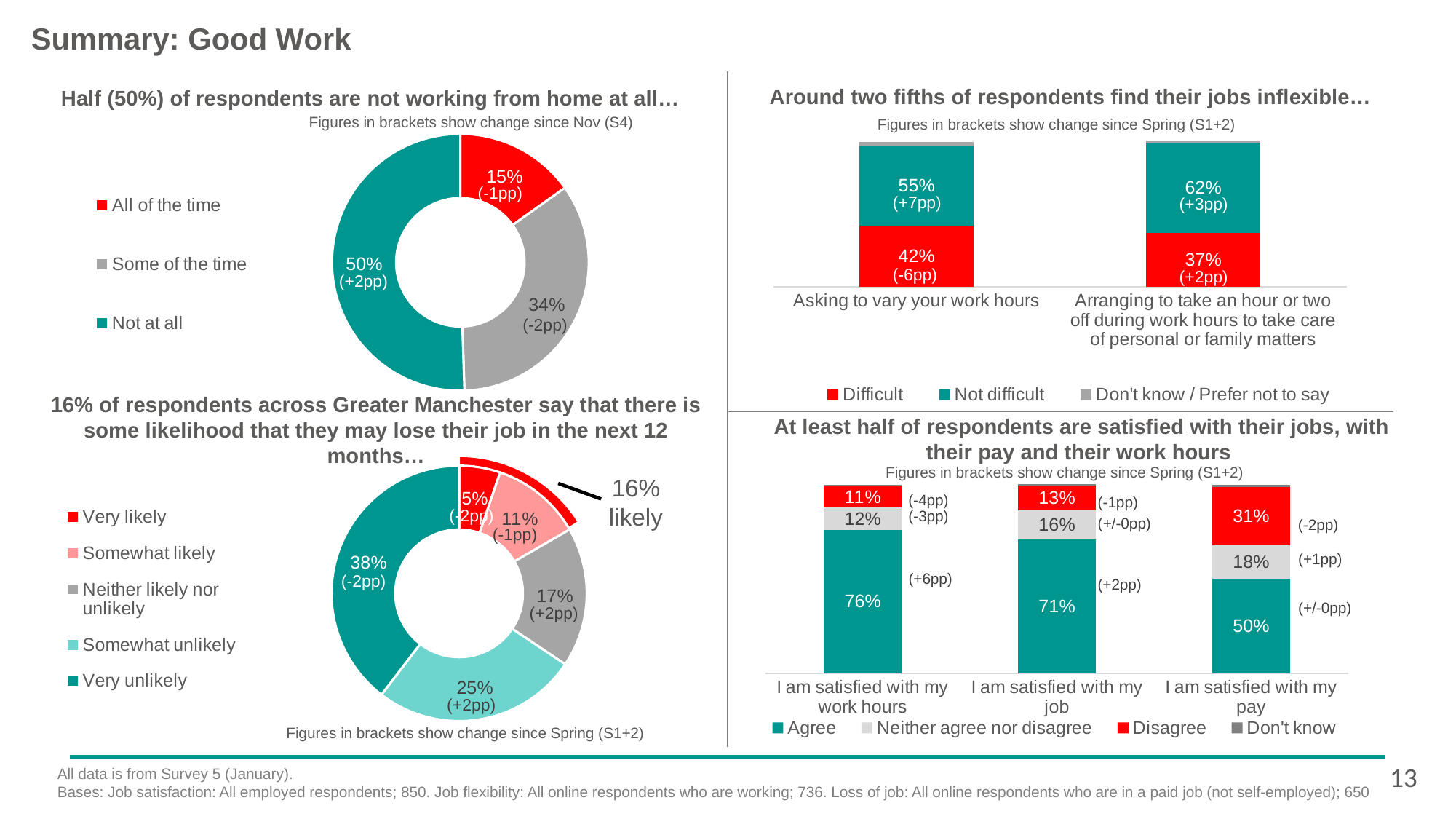
In the bottom-left chart about likelihood of losing their job, which category has the largest share? Very unlikely How many series does the legend of the top-right chart about job flexibility list? 3 In the bottom-right chart about job satisfaction, what percentage agree that they are satisfied with their pay? 50% In the top-right chart about job flexibility, what is the difference between the 'Not difficult' values for the two categories? 7 percentage points (62% vs 55%) In the bottom-left chart about likelihood of losing their job, what percentage of respondents say 'Somewhat unlikely'? 25% In the top-left chart about working from home, what percentage of respondents work from home some of the time? 34% What kind of chart is the top-left chart about working from home? Donut (pie) chart In the bottom-right chart about job satisfaction, which statement has the highest 'Disagree' value? I am satisfied with my pay In the top-left chart about working from home, what percentage of respondents are not working from home at all? 50% In the bottom-right chart about job satisfaction, is the 'Agree' value for 'I am satisfied with my work hours' larger or smaller than the 'Agree' value for 'I am satisfied with my job'? Larger How many categories does the legend of the bottom-left chart about likelihood of losing their job list? 5 In the top-right chart about job flexibility, what percentage find asking to vary their work hours difficult? 42%